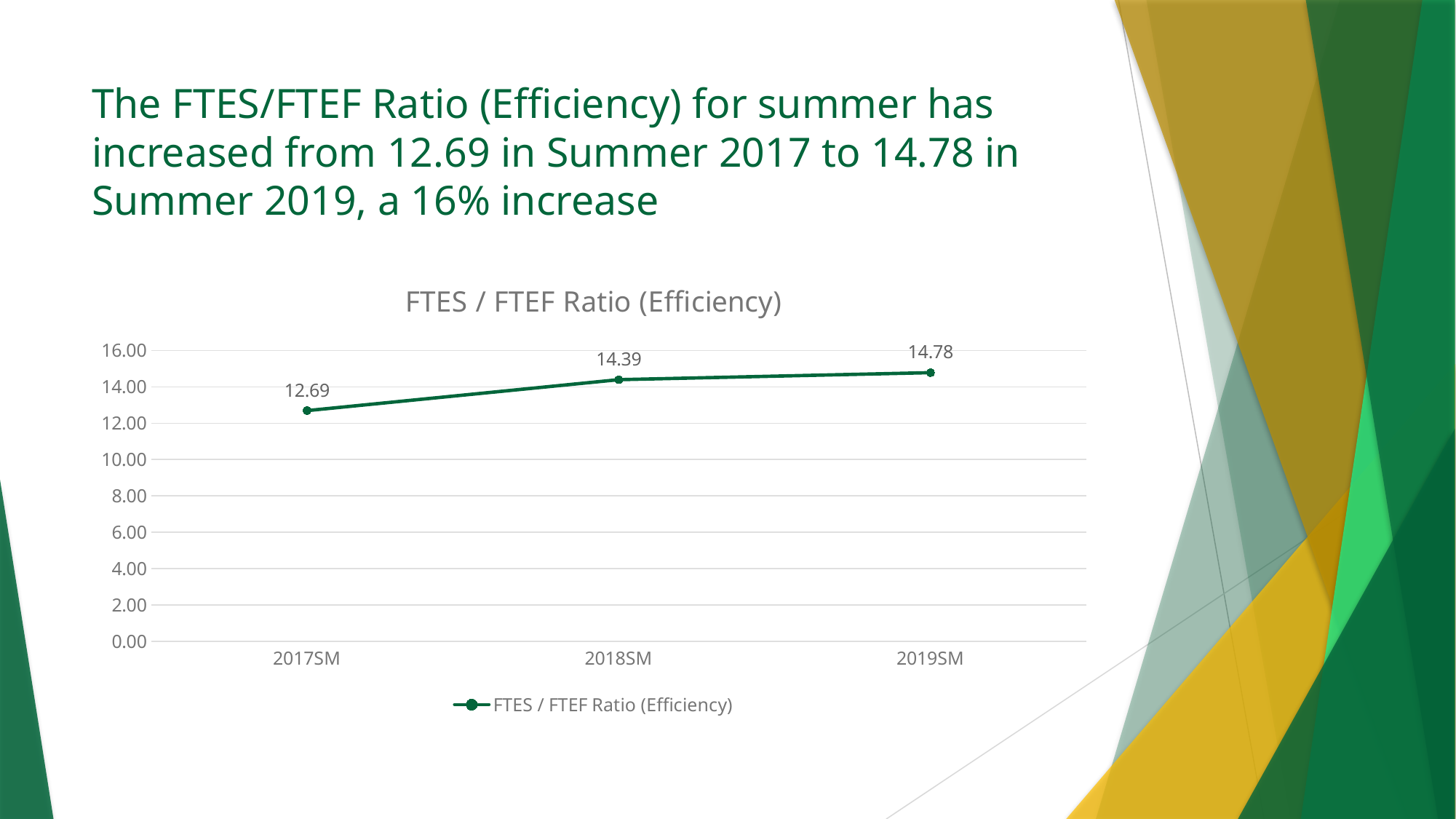
What kind of chart is shown on the slide? line chart What is the FTES / FTEF Ratio (Efficiency) for 2017SM? 12.69 Which is larger, the FTES / FTEF Ratio for 2018SM or for 2017SM? 2018SM What is the difference between the FTES / FTEF Ratio for 2018SM and 2017SM? 1.70 Is the FTES / FTEF Ratio for 2017SM greater or less than 14.00? less Which term has the highest FTES / FTEF Ratio (Efficiency)? 2019SM Which term has the lowest FTES / FTEF Ratio (Efficiency)? 2017SM How many terms are plotted on the chart? 3 What is the FTES / FTEF Ratio (Efficiency) for 2018SM? 14.39 What is the FTES / FTEF Ratio (Efficiency) for 2019SM? 14.78 What is the difference between the FTES / FTEF Ratio for 2019SM and 2017SM? 2.09 Does the FTES / FTEF Ratio rise or fall from 2017SM to 2019SM? rise